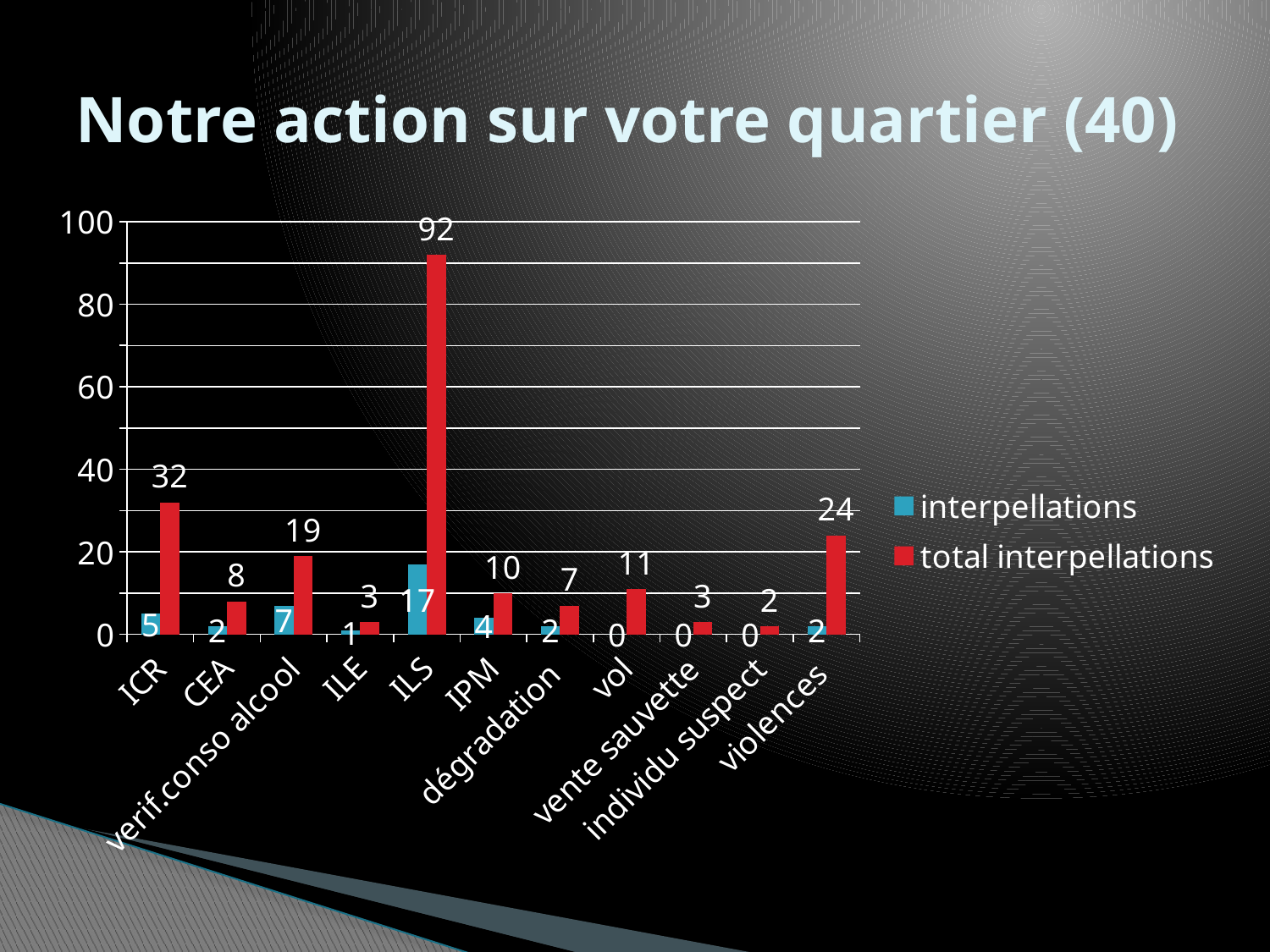
What is the value of total interpellations for ILS? 92 Which category has the highest total interpellations? ILS Is the value of total interpellations for ILS greater or less than 80? greater What kind of chart is shown on the slide? bar chart Which is larger, total interpellations for verif.conso alcool or for IPM? verif.conso alcool What is the value of total interpellations for violences? 24 What is the value of interpellations for ICR? 5 How many categories are shown on the x axis? 11 What is the title of the chart on the slide? Notre action sur votre quartier (40) Which category has the lowest total interpellations? individu suspect What is the difference between total interpellations for ICR and for violences? 8 How many series does the legend list? 2